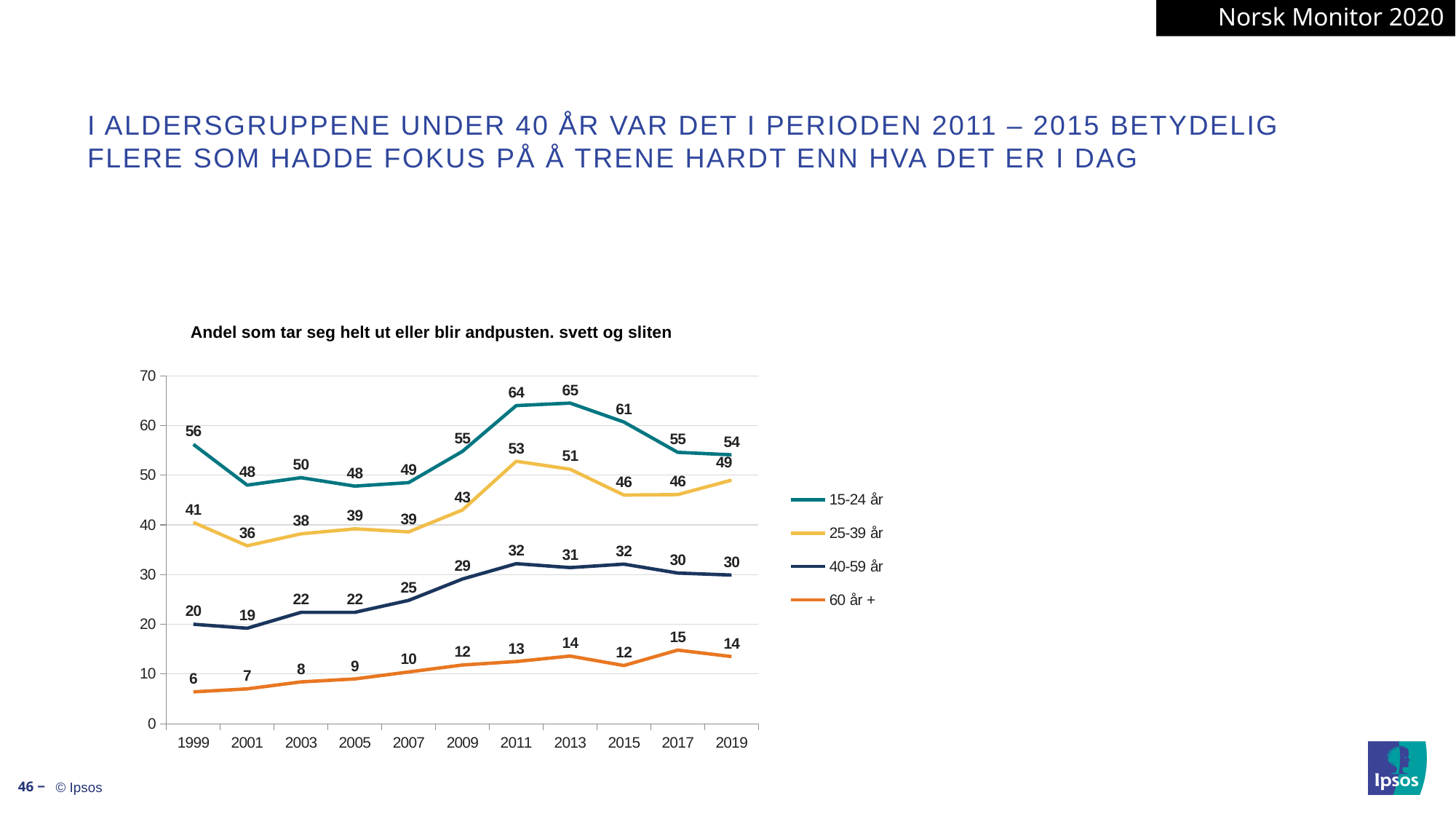
Does the 60 år + series generally rise or fall from 1999 to 2019? rise In which year does the 40-59 år series have its lowest value? 2001 In which year does the 15-24 år series reach its highest value? 2013 How many years are shown on the x axis? 11 What is the value for the 25-39 år series in 2011? 53 What is the title of the chart? Andel som tar seg helt ut eller blir andpusten. svett og sliten Which series has the higher value in 2019: 25-39 år or 40-59 år? 25-39 år What is the value for the 60 år + series in 1999? 6 What is the difference between the 15-24 år value in 2013 and its value in 2019? 11 What is the value for the 15-24 år series in 2013? 65 How many series does the legend list? 4 What type of chart is shown on the slide? line chart